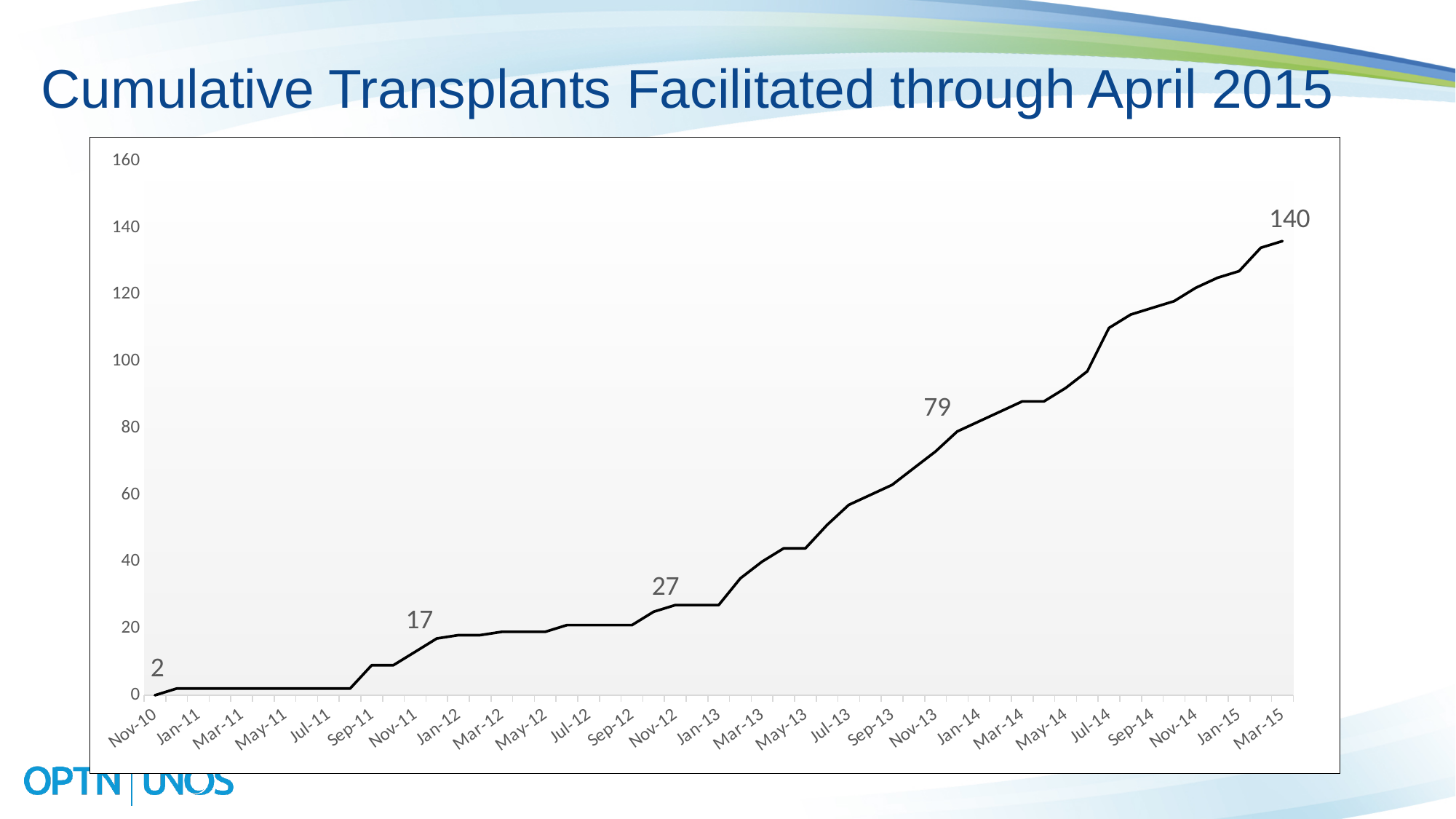
What is the final (rightmost) labeled value on the line? 140 What kind of chart is shown on the slide? line chart What is the lowest value labeled on the chart? 2 What is the difference between the labeled values 27 and 17? 10 What is the title of the chart? Cumulative Transplants Facilitated through April 2015 Do the values rise or fall from Nov-10 to Mar-15? rise How many data labels are printed on the line? 5 What is the first labeled value at the start of the line, near Nov-10? 2 Is the value for Jul-14 greater or less than 100? greater What is the highest value labeled on the chart? 140 What is the difference between the labeled values 140 and 79? 61 What is the labeled value on the line near the end of 2013? 79